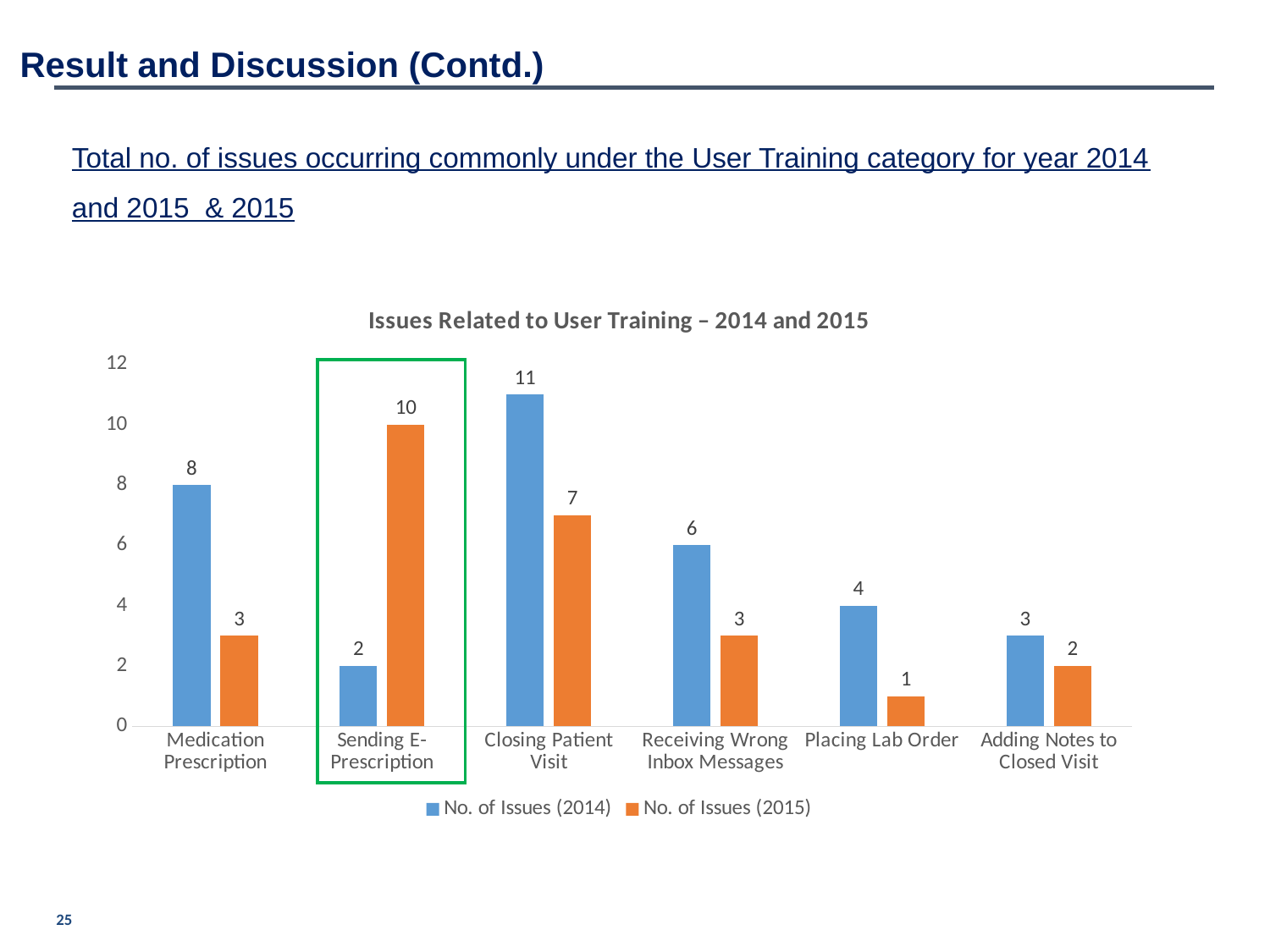
Which category has the highest number of issues in 2014? Closing Patient Visit Which category has the lowest number of issues in 2015? Placing Lab Order What is the number of issues in 2014 for Medication Prescription? 8 How many series does the legend list? 2 How many categories are shown on the x axis? 6 What is the number of issues in 2015 for Sending E-Prescription? 10 What is the title of the chart? Issues Related to User Training – 2014 and 2015 Which category is highlighted with a green box? Sending E-Prescription What is the number of issues in 2015 for Placing Lab Order? 1 Which is larger for Sending E-Prescription: the number of issues in 2014 or in 2015? 2015 What kind of chart is shown? Bar chart What is the difference between the 2014 and 2015 number of issues for Closing Patient Visit? 4